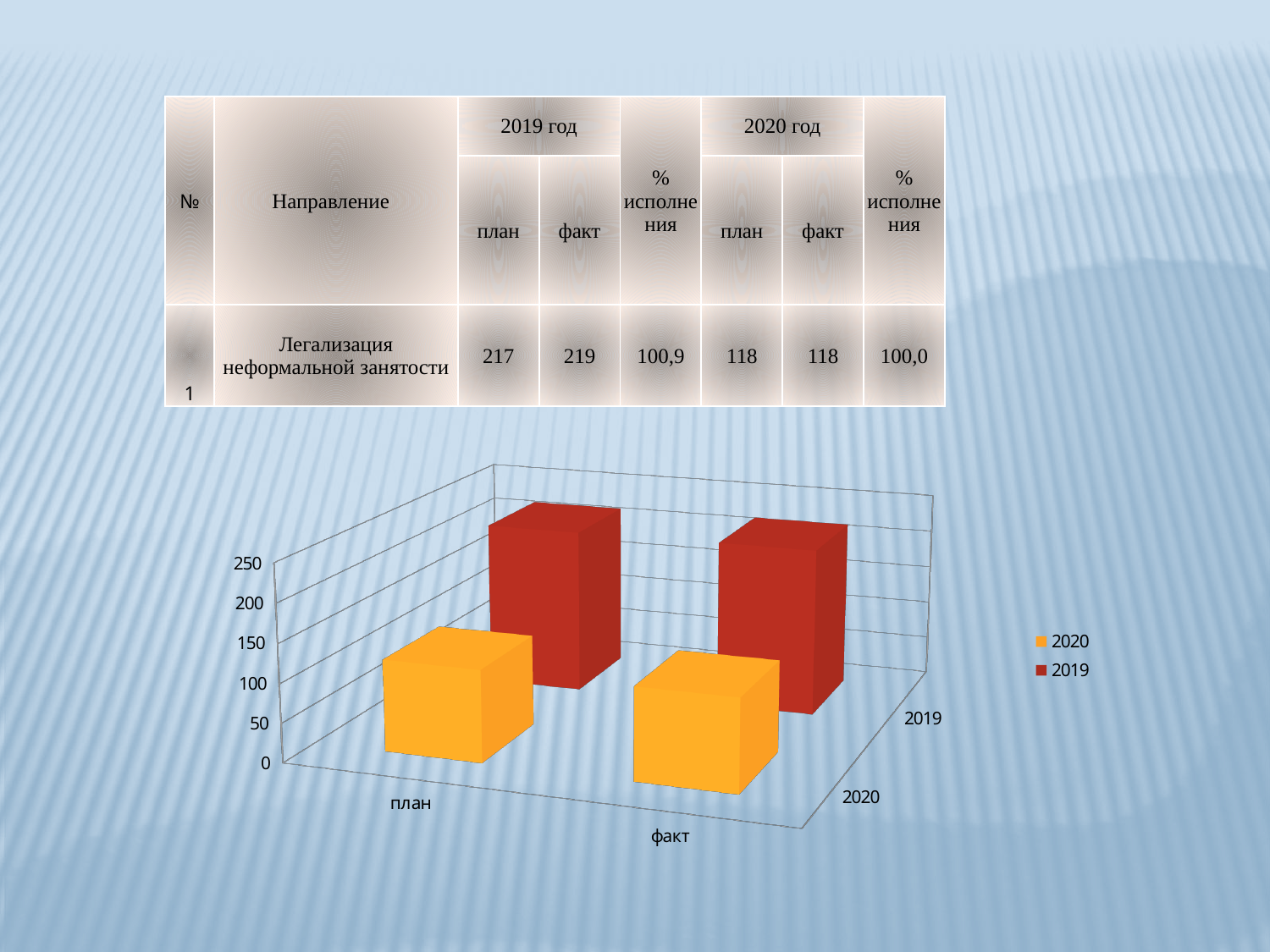
For the category факт, which year has the larger value, 2019 or 2020? 2019 Is the value for факт in 2020 greater or less than 150? less For the category план, which year has the larger value, 2019 or 2020? 2019 Which colour represents the 2019 series in the chart? red How many categories are shown along the x axis of the chart? 2 What kind of chart is shown on the slide? bar chart Is the value for факт in 2019 greater or less than 200? greater How many series does the chart legend list? 2 Is the value for план in 2019 greater or less than 200? greater According to the table above the chart, what is the план value for 2019? 217 What are the two entries in the chart legend? 2020 and 2019